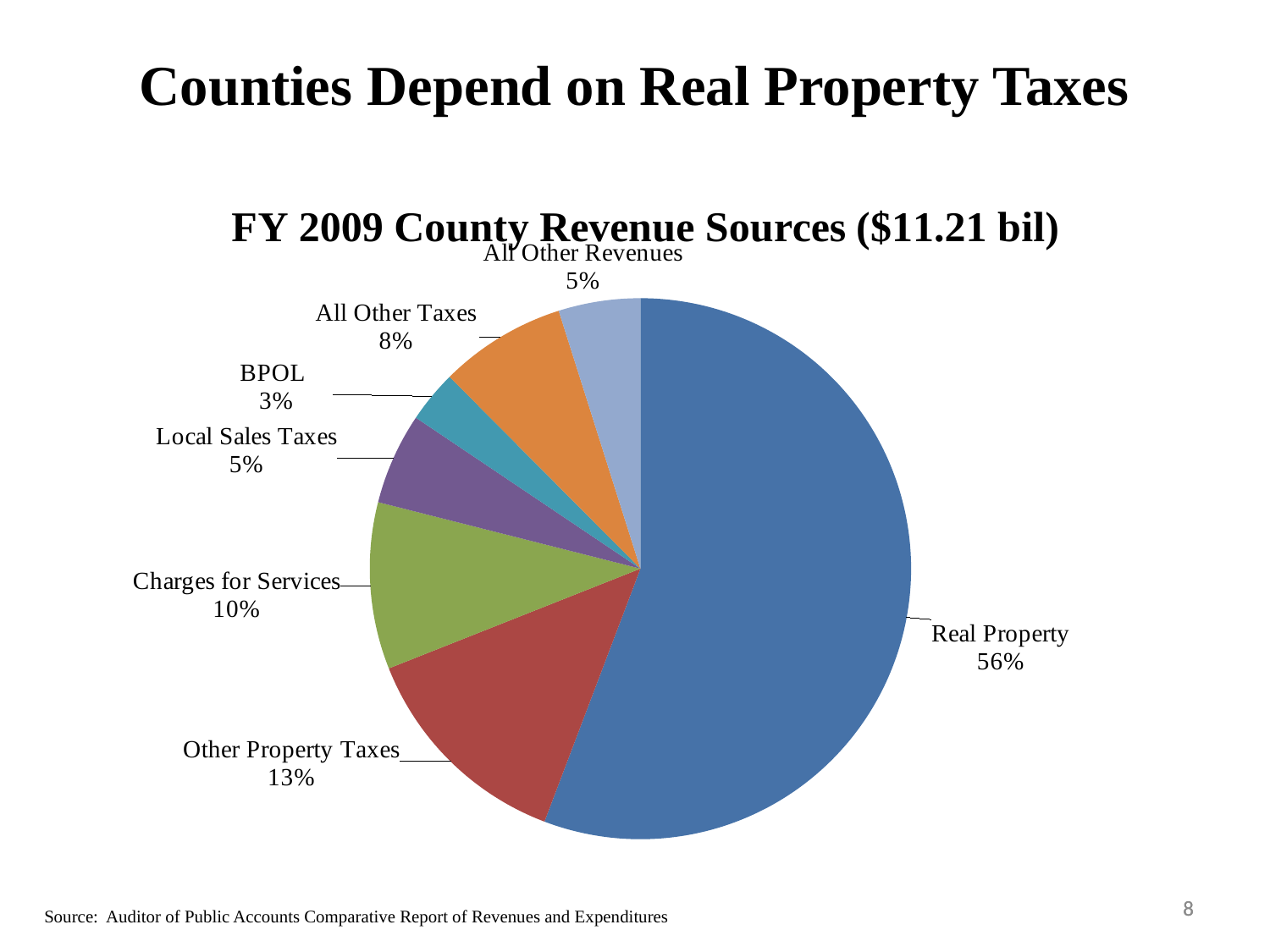
What share of county revenue comes from BPOL? 3% How many slices does the pie chart have? 7 What share of county revenue comes from All Other Taxes? 8% What is the title of the pie chart? FY 2009 County Revenue Sources ($11.21 bil) What is the difference in percentage points between Real Property and Other Property Taxes? 43 What share of county revenue comes from Other Property Taxes? 13% What kind of chart is shown on the slide? pie chart Which revenue source has the smallest share of the pie? BPOL Which revenue source has the largest share of the pie? Real Property Which is larger, the share for Charges for Services or the share for All Other Taxes? Charges for Services